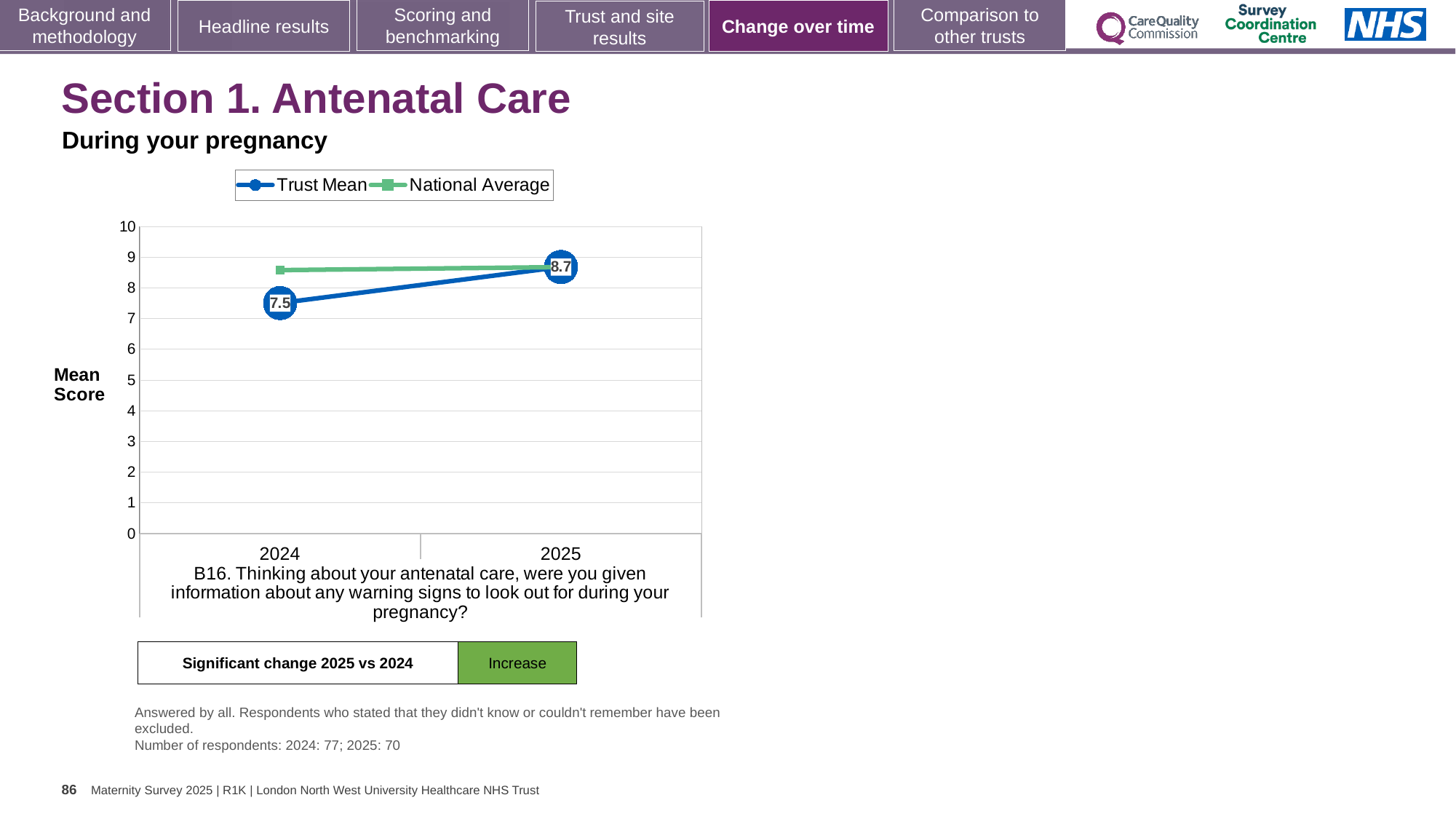
What is the Trust Mean value for 2025? 8.7 How many years are shown on the x axis? 2 In 2024, which is higher, the Trust Mean or the National Average? National Average What is the Trust Mean value for 2024? 7.5 In which year is the Trust Mean higher, 2024 or 2025? 2025 How many series does the legend list? 2 What kind of chart is shown on the slide? line chart Is the National Average value for 2024 greater or less than 8? greater What is the label of the y axis? Mean Score What is the difference between the Trust Mean in 2025 and in 2024? 1.2 Does the Trust Mean rise or fall from 2024 to 2025? rise Is the National Average value for 2025 greater or less than 9? less